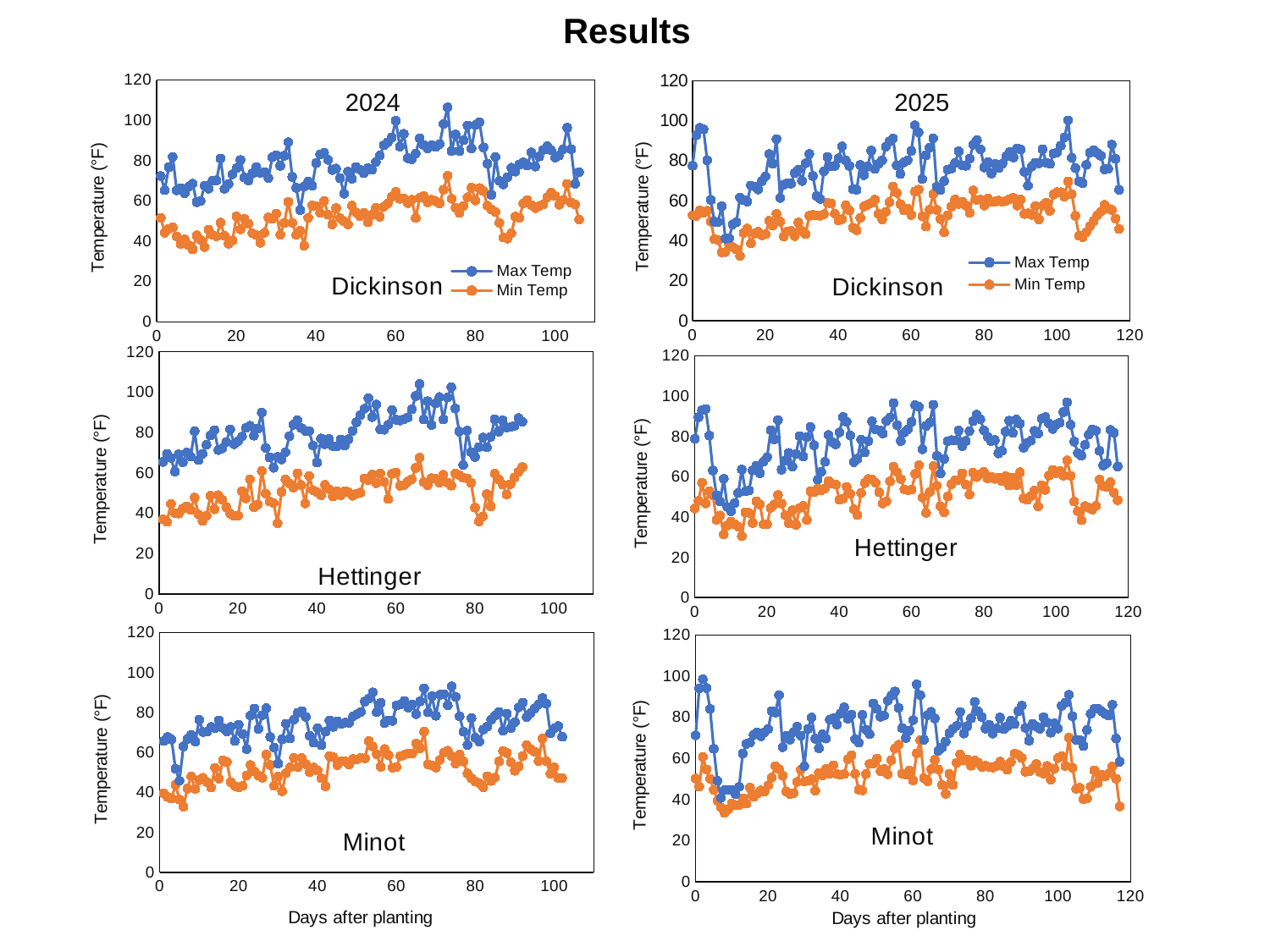
In the 2025 Hettinger chart, which series is lower throughout, Max Temp or Min Temp? Min Temp In the 2025 Hettinger chart, is the Max Temp value at day 0 greater or less than 40? greater How many series does the legend list in the 2025 Dickinson chart? 2 In the 2024 Dickinson chart, which series is higher throughout, Max Temp or Min Temp? Max Temp In the 2025 Dickinson chart, is the Min Temp value at day 0 greater or less than 40? greater What are the two legend entries in the 2024 Dickinson chart? Max Temp, Min Temp What kind of chart is the 2024 Dickinson chart? line chart In the 2025 Minot chart, is the Max Temp value at day 0 greater or less than 60? greater How many charts are shown on the slide? 6